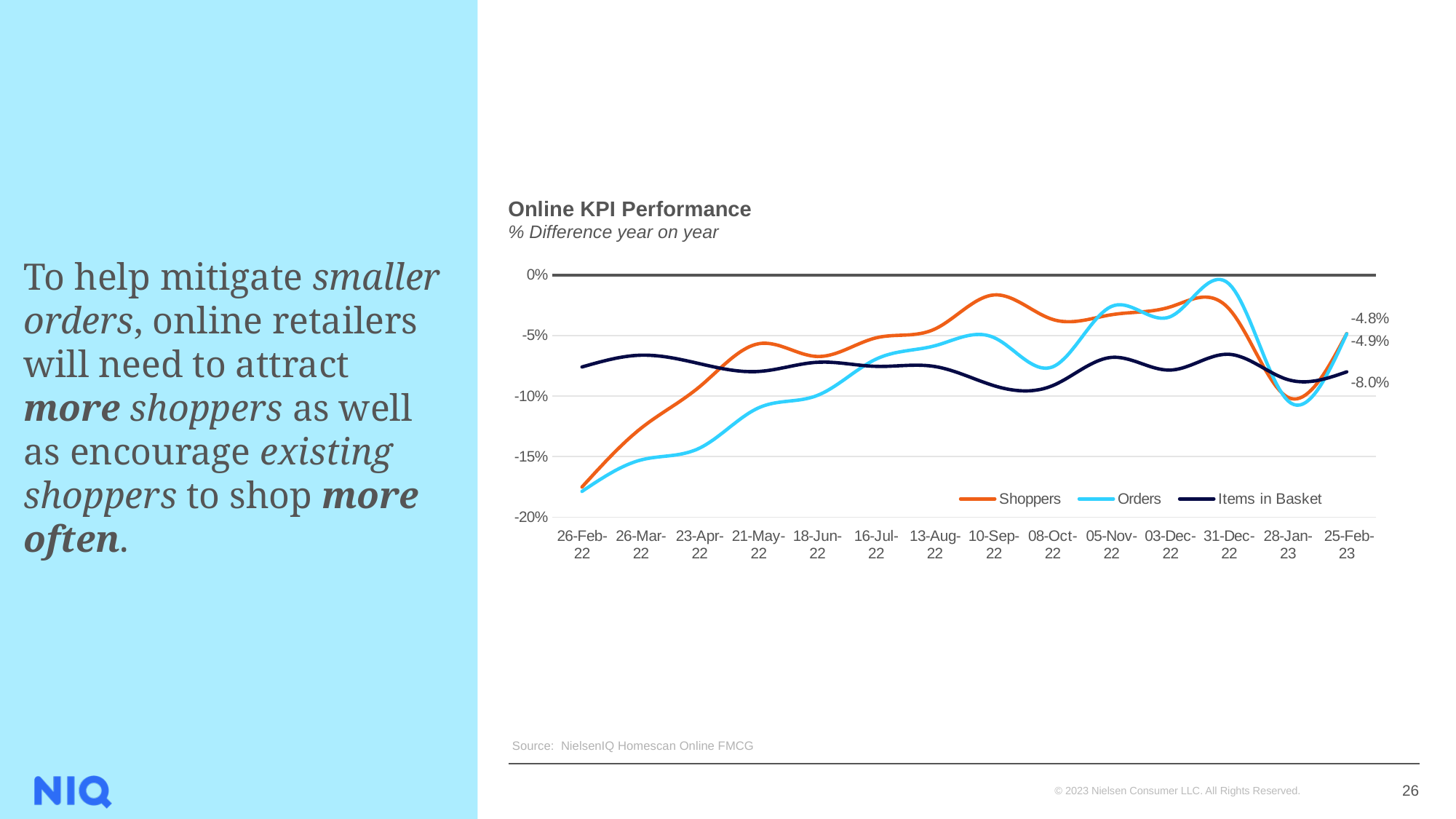
What is the subtitle of the Online KPI Performance chart? % Difference year on year How many series does the legend of the Online KPI Performance chart list? 3 At 26-Feb-22, which is higher: Shoppers or Items in Basket? Items in Basket Does the Shoppers series rise or fall between 26-Feb-22 and 10-Sep-22? rise What is the value for Items in Basket at 25-Feb-23? -8.0% Is the value for Orders at 23-Apr-22 greater or less than -10%? less Is the value for Items in Basket at 26-Feb-22 greater or less than -10%? greater Is the value for Orders at 31-Dec-22 greater or less than -5%? greater What kind of chart is shown on the slide? line chart At which date is the Shoppers series at its lowest? 26-Feb-22 How many dates are shown on the x axis of the Online KPI Performance chart? 14